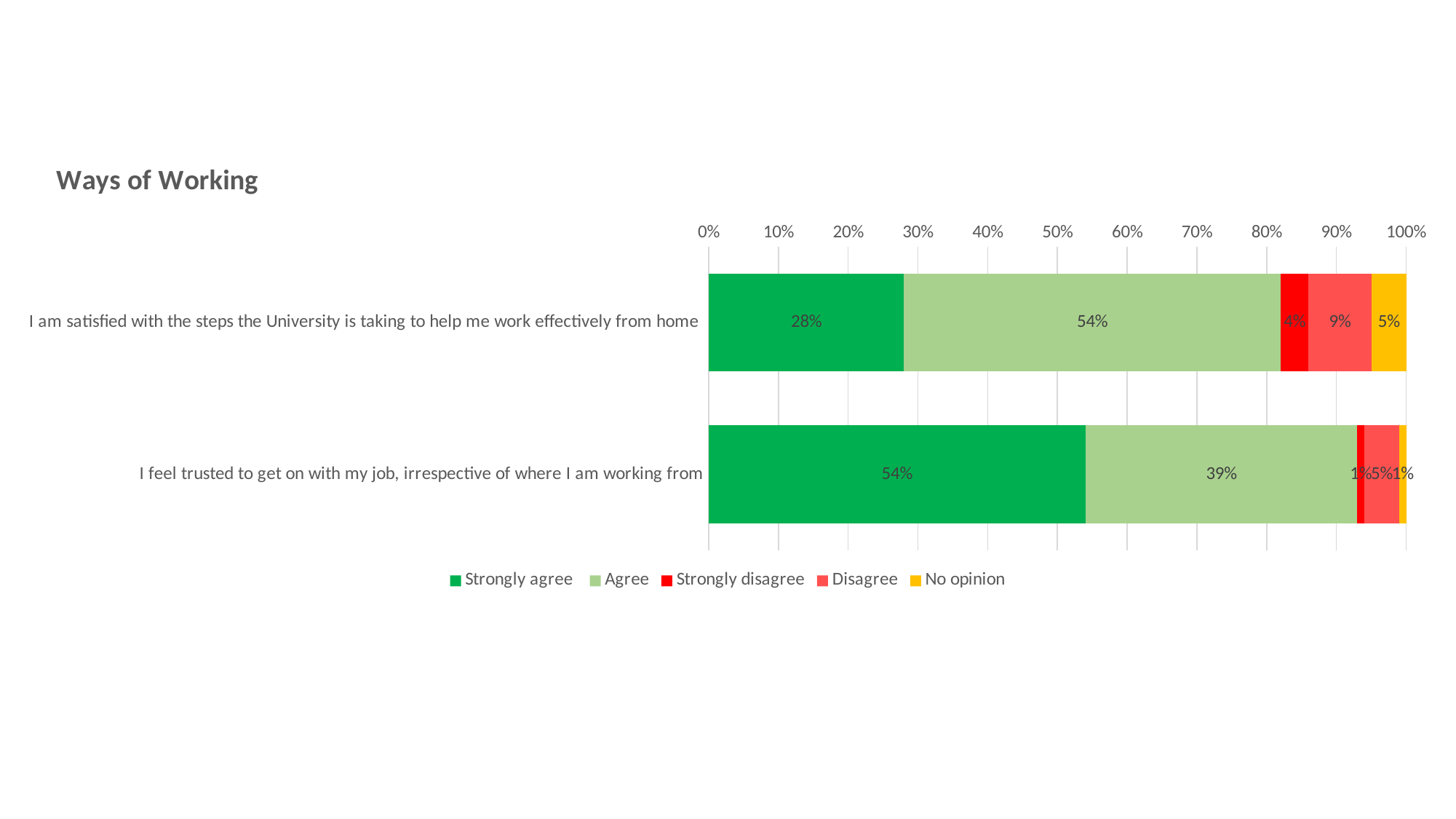
How many statements (categories) are plotted in the chart? 2 What is the difference in 'Strongly agree' share between the two statements? 26 percentage points How many series does the legend list? 5 What percentage strongly agree with 'I feel trusted to get on with my job, irrespective of where I am working from'? 54% Which statement has the larger 'Strongly agree' share? I feel trusted to get on with my job, irrespective of where I am working from What percentage disagree with 'I am satisfied with the steps the University is taking to help me work effectively from home'? 9% What percentage agree with 'I am satisfied with the steps the University is taking to help me work effectively from home'? 54% What percentage strongly agree with 'I am satisfied with the steps the University is taking to help me work effectively from home'? 28% What percentage agree with 'I feel trusted to get on with my job, irrespective of where I am working from'? 39% What kind of chart is shown on the slide? Stacked bar chart What is the 'No opinion' share for 'I am satisfied with the steps the University is taking to help me work effectively from home'? 5% What is the title of the chart? Ways of Working